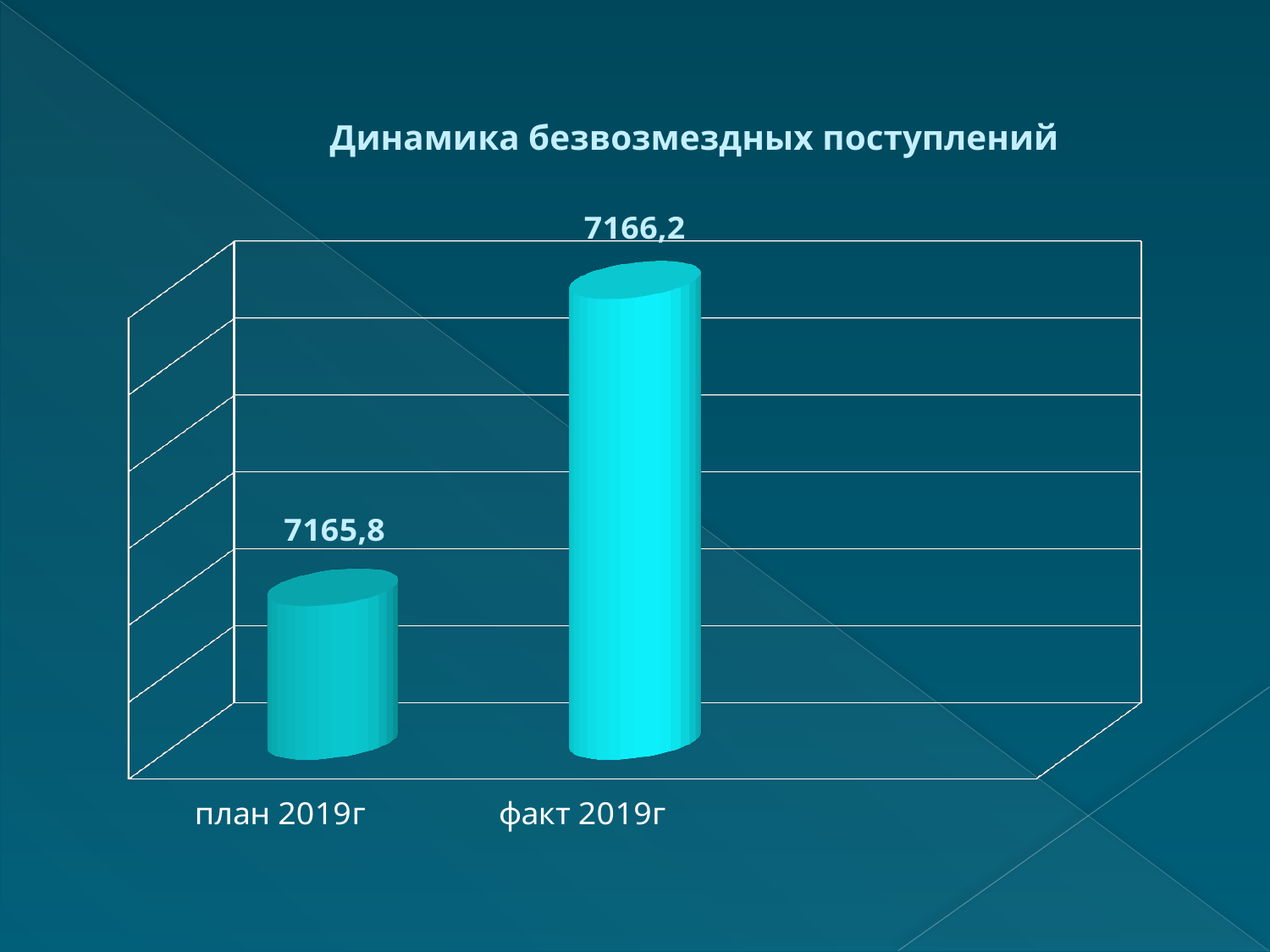
Which category has the highest value? факт 2019г What is the title of the chart? Динамика безвозмездных поступлений Which is larger, the value for план 2019г or the value for факт 2019г? факт 2019г What is the difference between the values for факт 2019г and план 2019г? 0,4 What kind of chart is shown on the slide? bar chart What are the two category labels on the x axis? план 2019г, факт 2019г What is the value for факт 2019г? 7166,2 How many categories are shown in the chart? 2 What is the value for план 2019г? 7165,8 Which category has the lowest value? план 2019г Do the values rise or fall from план 2019г to факт 2019г? rise